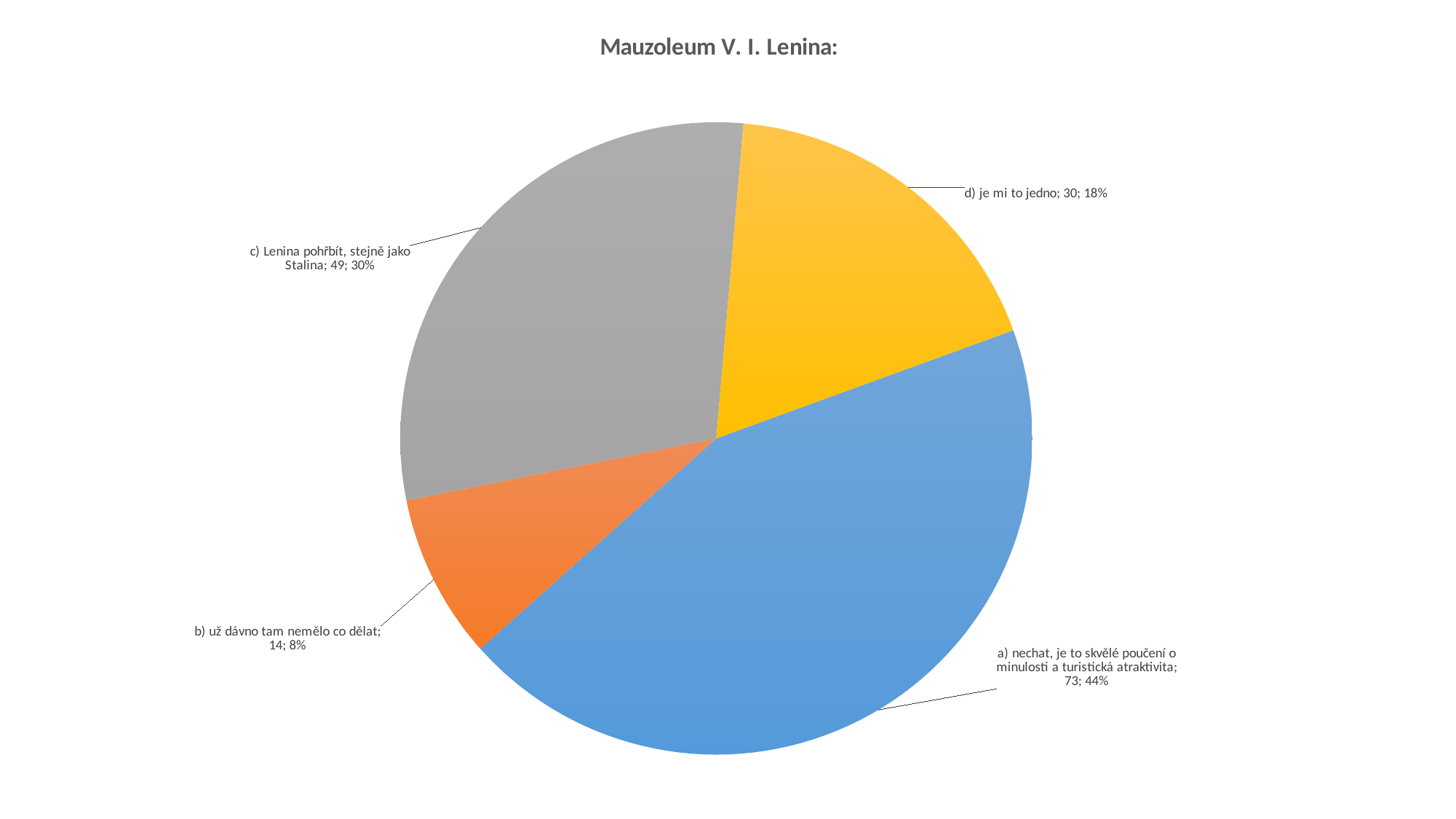
What is the value for "b) už dávno tam nemělo co dělat"? 14 What share of the pie does "d) je mi to jedno" represent? 18% What is the difference between the values for "a) nechat, je to skvělé poučení o minulosti a turistická atraktivita" and "c) Lenina pohřbít, stejně jako Stalina"? 24 What is the value for "c) Lenina pohřbít, stejně jako Stalina"? 49 What is the value for "d) je mi to jedno"? 30 What kind of chart is shown on the slide? pie chart What is the value for "a) nechat, je to skvělé poučení o minulosti a turistická atraktivita"? 73 How many slices does the pie chart have? 4 Which category has the largest slice? a) nechat, je to skvělé poučení o minulosti a turistická atraktivita Which category has the smallest slice? b) už dávno tam nemělo co dělat What is the title of the chart? Mauzoleum V. I. Lenina: What share of the pie does "c) Lenina pohřbít, stejně jako Stalina" represent? 30%